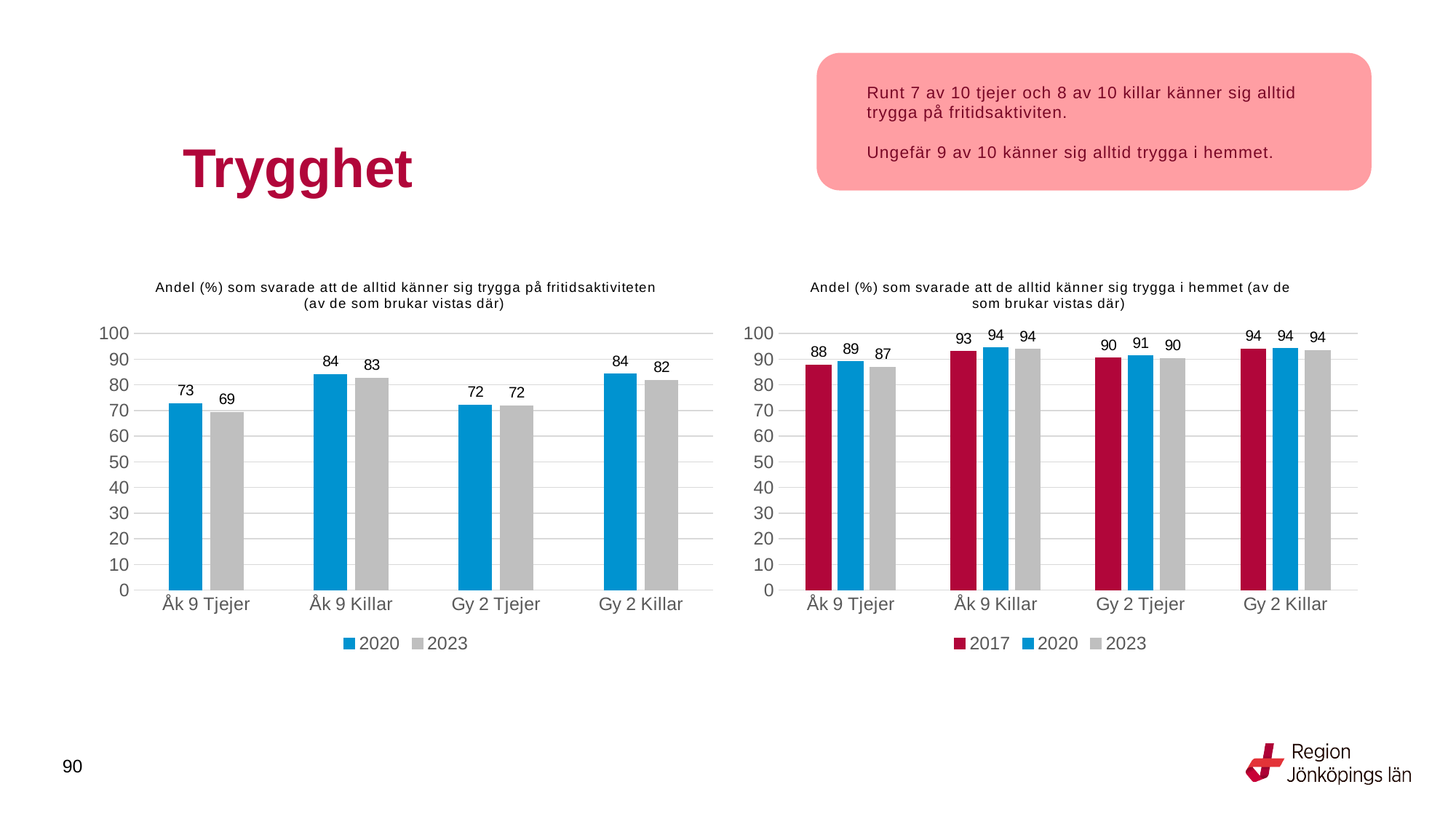
In the right chart (trygga i hemmet), what is the value for Åk 9 Tjejer in 2017? 88 In the right chart (trygga i hemmet), what is the difference between the 2020 and 2023 values for Åk 9 Tjejer? 2 How many categories are shown on the x axis of the left chart (trygga på fritidsaktiviteten)? 4 In the left chart (trygga på fritidsaktiviteten), what is the difference between the 2020 and 2023 values for Åk 9 Tjejer? 4 In the right chart (trygga i hemmet), which category has the lowest 2023 value? Åk 9 Tjejer What kind of chart is the right chart (trygga i hemmet)? Bar chart In the left chart (trygga på fritidsaktiviteten), what is the value for Åk 9 Tjejer in 2023? 69 In the right chart (trygga i hemmet), what is the value for Gy 2 Tjejer in 2023? 90 In the left chart (trygga på fritidsaktiviteten), what is the value for Gy 2 Killar in 2020? 84 How many series does the legend of the right chart (trygga i hemmet) list? 3 In the left chart (trygga på fritidsaktiviteten), which is larger: the 2020 value for Åk 9 Killar or the 2020 value for Gy 2 Tjejer? Åk 9 Killar In the left chart (trygga på fritidsaktiviteten), which category has the lowest 2023 value? Åk 9 Tjejer